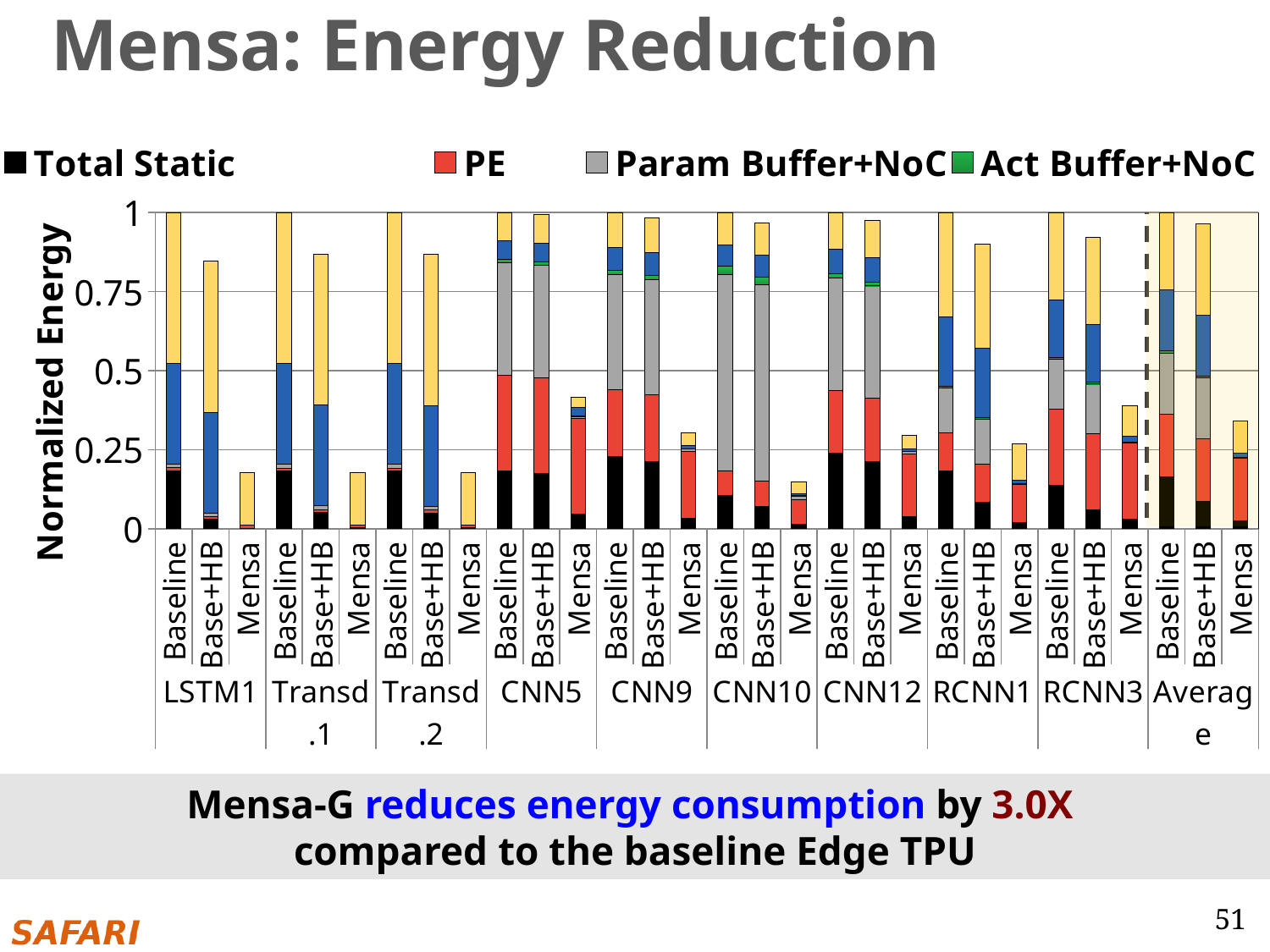
What is the y-axis title of the chart? Normalized Energy What kind of chart is shown on the slide? Stacked bar chart What is the total normalized energy of the Baseline bar for LSTM1? 1 Which is larger: the Mensa total for CNN5 or the Mensa total for LSTM1? CNN5 How many series does the legend list? 4 Is the total for Mensa in CNN5 greater or less than 0.5? less How many bars are plotted for each workload group? 3 Is the total for Base+HB in LSTM1 greater or less than 0.75? greater Which configuration has the lowest total normalized energy in the CNN10 group? Mensa Is the total for Mensa in the Average group greater or less than 0.25? greater How many workload groups are shown along the x axis (including Average)? 10